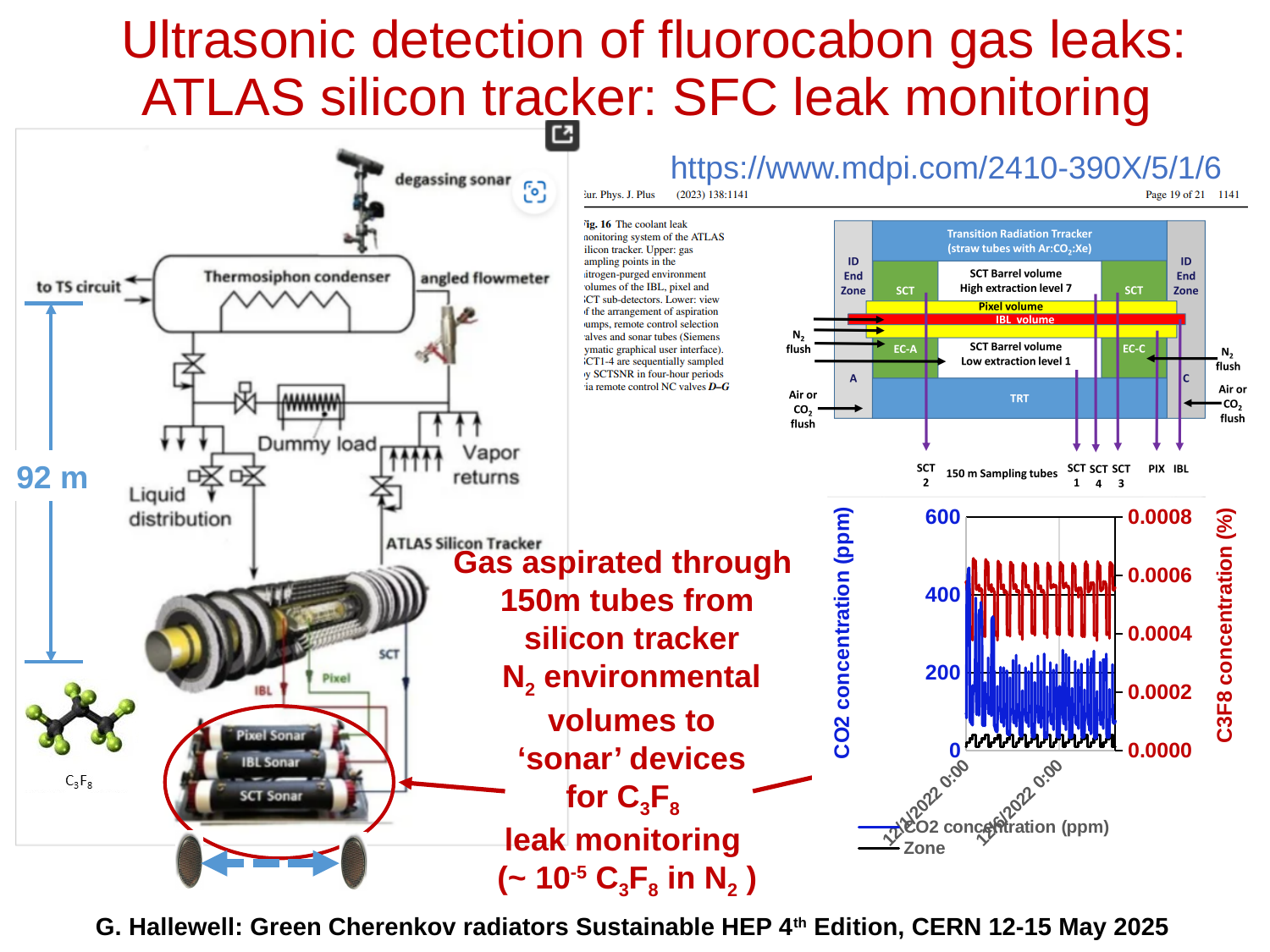
What is the lowest tick value shown on the right (C3F8) axis of the chart? 0.0000 What is the highest tick value shown on the left (CO2) axis of the chart? 600 What is the highest tick value shown on the right (C3F8) axis of the chart? 0.0008 What is the label of the right vertical axis of the chart at the bottom right? C3F8 concentration (%) In the chart, are the lowest values of the blue CO2 concentration line greater or less than 200 ppm? less In the chart, are the highest peaks of the blue CO2 concentration line greater or less than 400 ppm? greater In the chart, are the peak values of the red C3F8 concentration line greater or less than 0.0008? less Which colour is used for the CO2 concentration line in the chart? blue What kind of chart is shown at the bottom right of the slide? line chart What is the label of the left vertical axis of the chart at the bottom right? CO2 concentration (ppm)